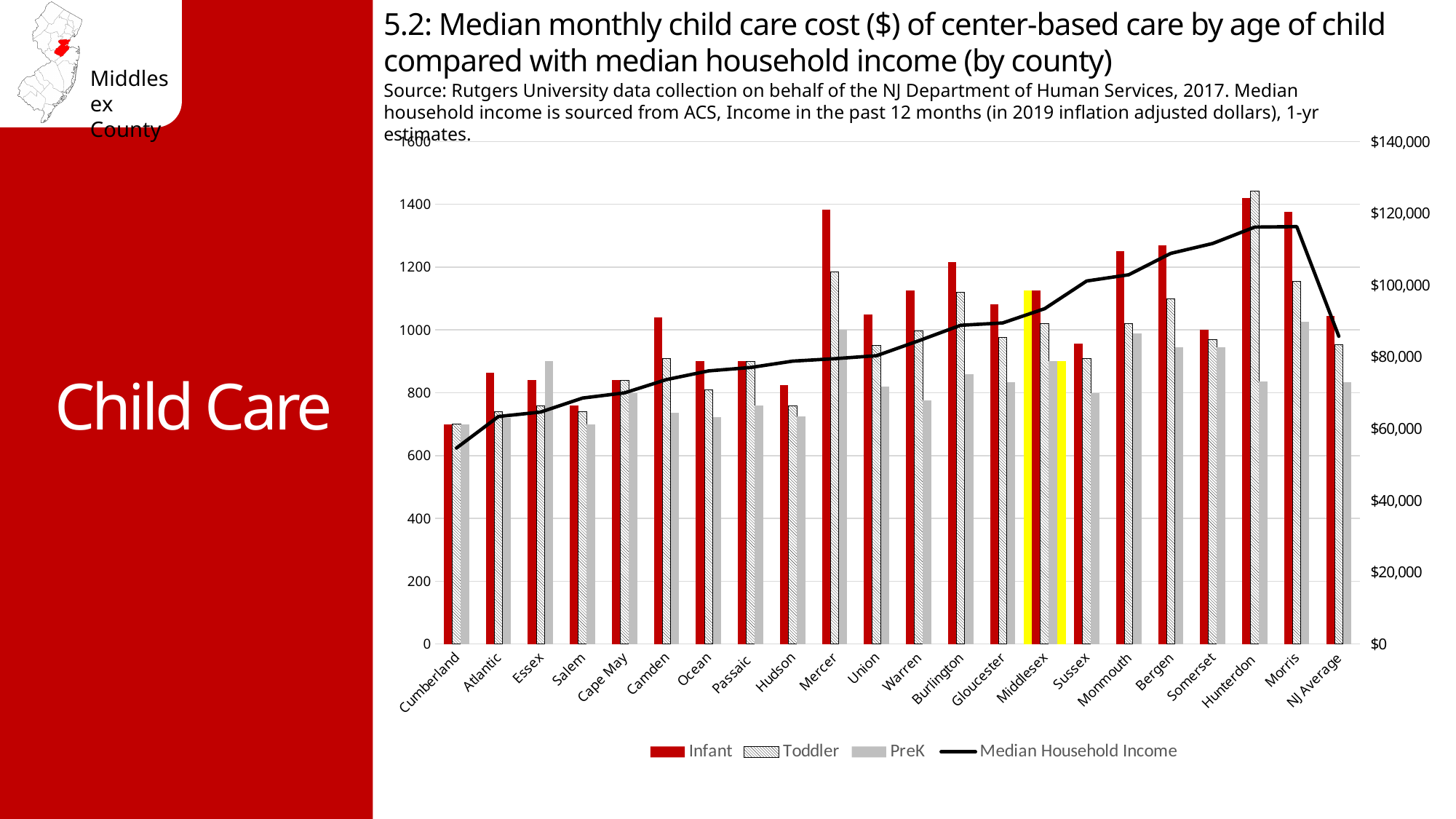
Does the Median Household Income line generally rise or fall from Cumberland to Morris? rise How many series does the chart legend list? 4 Which county has the highest Toddler child care cost? Hunterdon What kind of chart is used to show the child care costs by age of child? Bar chart (with a line for median household income) How many counties/categories are shown along the x axis of the chart? 22 Is the median household income for Morris greater or less than $100,000? greater Is the median household income for Cumberland greater or less than $60,000? less Which county's bars are highlighted in yellow on the chart? Middlesex Is the Infant child care cost for Cumberland greater or less than 800? less Which is larger for Essex: the Infant cost or the PreK cost? PreK Which county has the lowest Infant child care cost? Cumberland